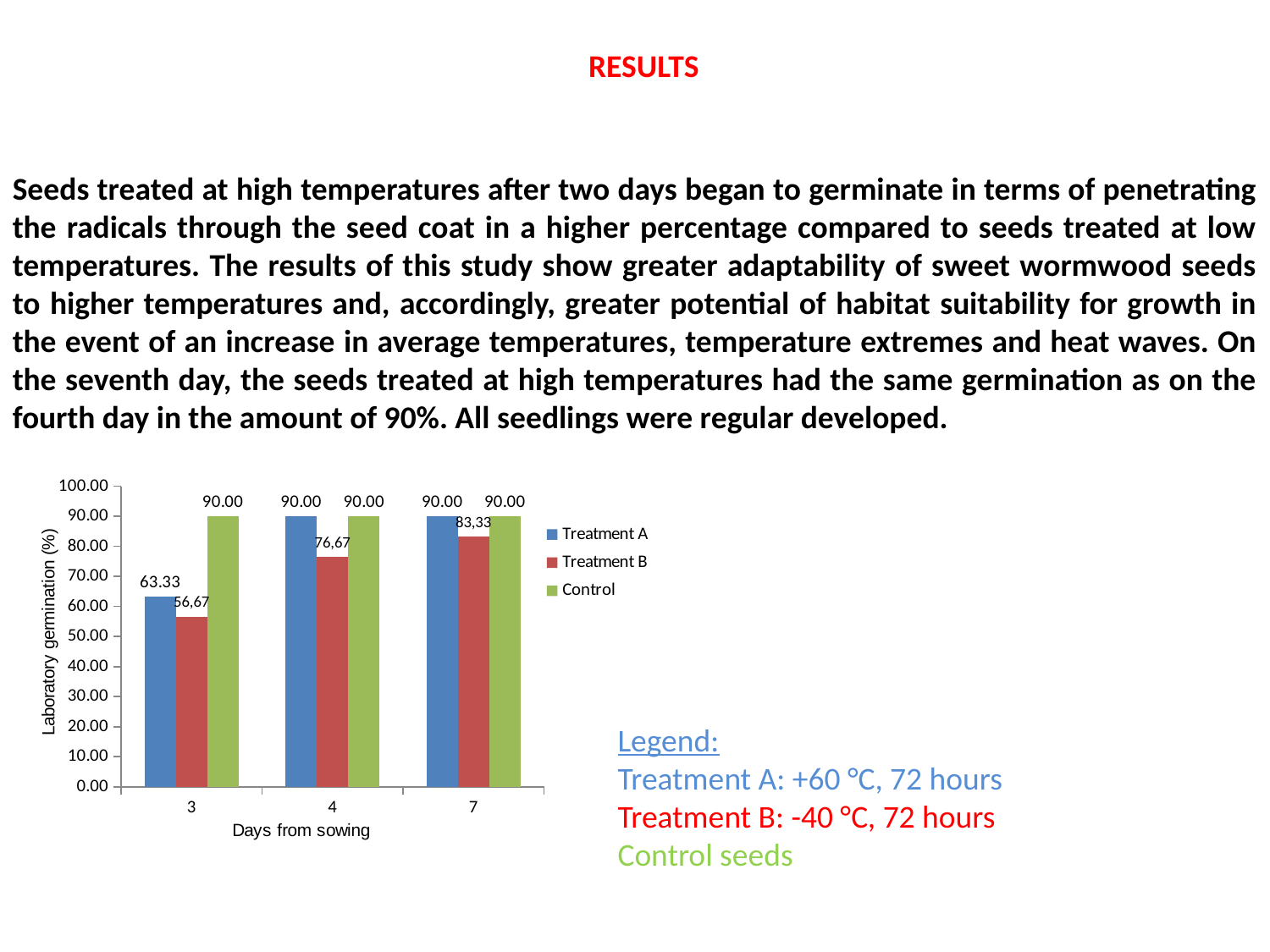
What is the laboratory germination for Treatment B at 7 days from sowing? 83,33 Which is larger at 4 days from sowing, Treatment A or Treatment B? Treatment A Which series has the lowest value at 3 days from sowing? Treatment B What type of chart is shown on the slide? bar chart What is the laboratory germination for Treatment B at 4 days from sowing? 76,67 How many categories are shown on the x axis? 3 What is the laboratory germination for Treatment A at 3 days from sowing? 63.33 How many series does the legend list? 3 Does the Treatment B value rise or fall from day 3 to day 7? rise At which day from sowing is the Treatment B value lowest? 3 What is the laboratory germination for Control at 7 days from sowing? 90.00 What is the difference between the Control and Treatment A values at 3 days from sowing? 26.67